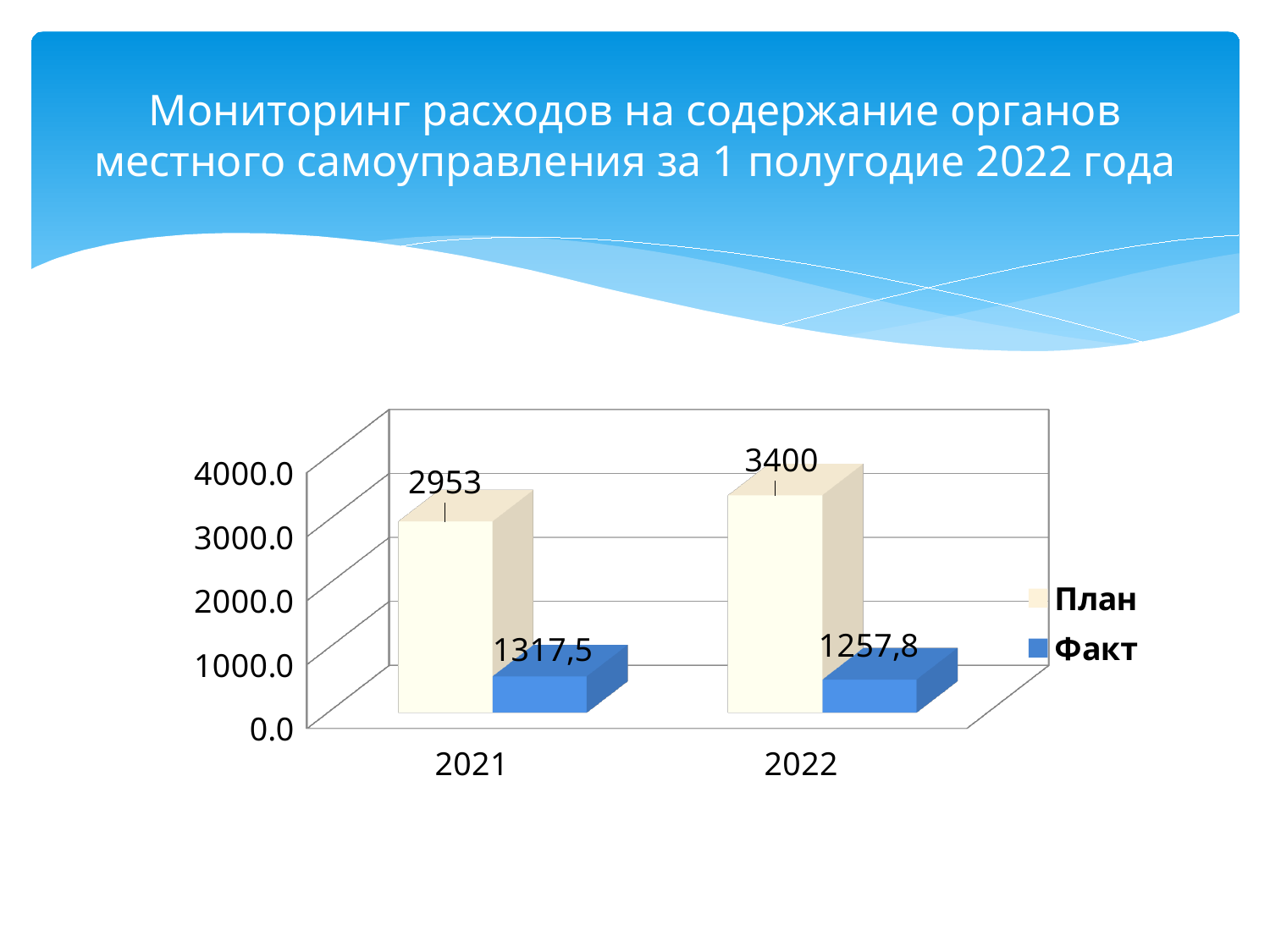
What kind of chart is shown on the slide? bar chart Is the Факт value for 2021 larger or smaller than the Факт value for 2022? larger What is the План value for 2022? 3400 Which year has the higher План value? 2022 What is the difference between the План values for 2022 and 2021? 447 How many years are shown on the x axis? 2 What is the Факт value for 2022? 1257,8 What is the Факт value for 2021? 1317,5 What is the План value for 2021? 2953 How many series does the legend list? 2 Which year has the lower Факт value? 2022 Is the План value for 2022 greater or less than 3000.0? greater